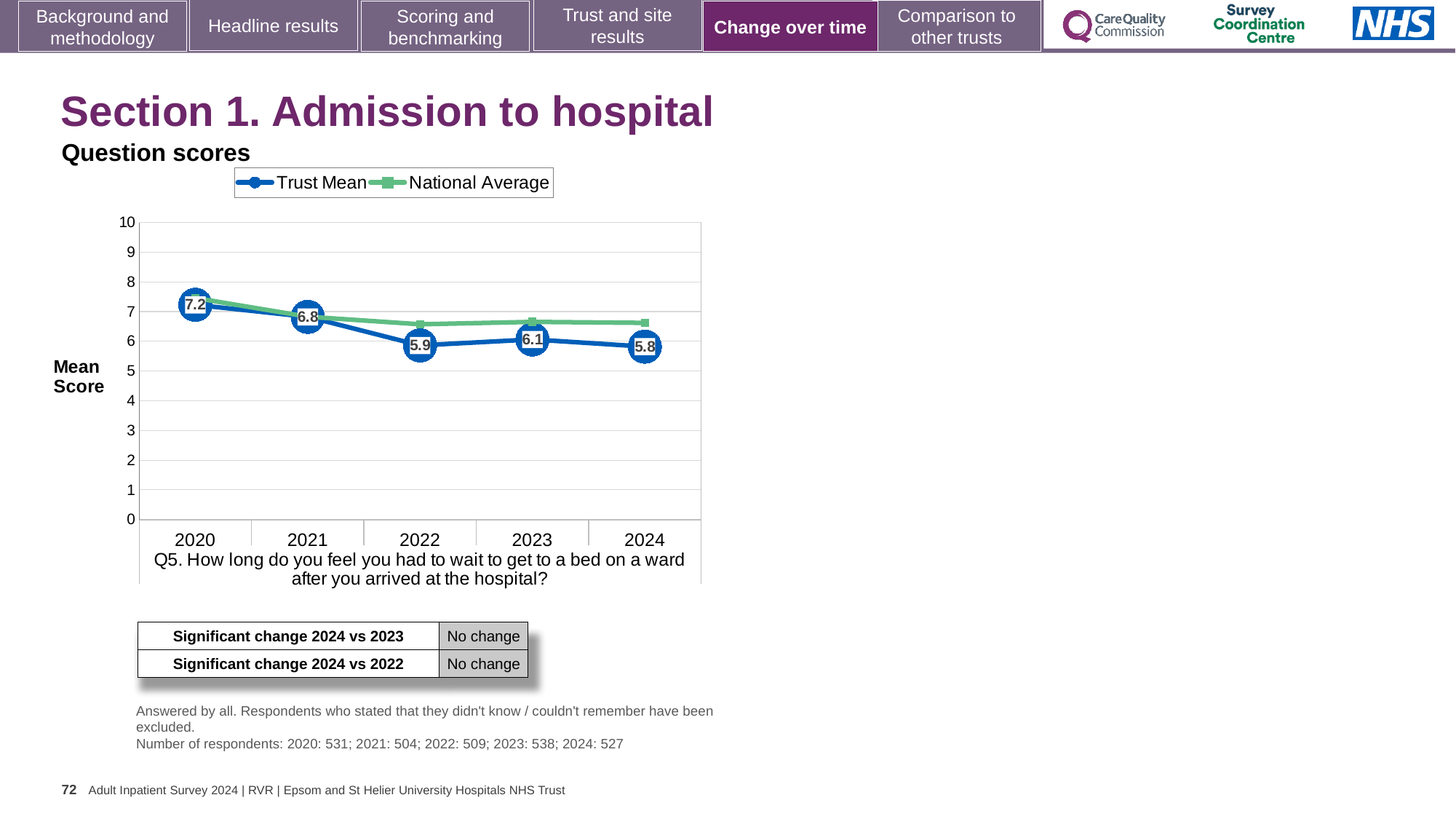
What is the Trust Mean score for 2022? 5.9 In which year is the Trust Mean score lowest? 2024 What is the difference between the Trust Mean scores for 2020 and 2024? 1.4 What kind of chart is shown on the slide? Line chart What is the Trust Mean score for 2024? 5.8 In which year is the Trust Mean score highest? 2020 What is the Trust Mean score for 2020? 7.2 Which year has the larger Trust Mean score, 2021 or 2023? 2021 How many series does the chart legend list? 2 Is the National Average value for 2020 greater or less than 7? greater How many years are shown on the x axis of the chart? 5 Does the Trust Mean score generally rise or fall from 2020 to 2024? Fall